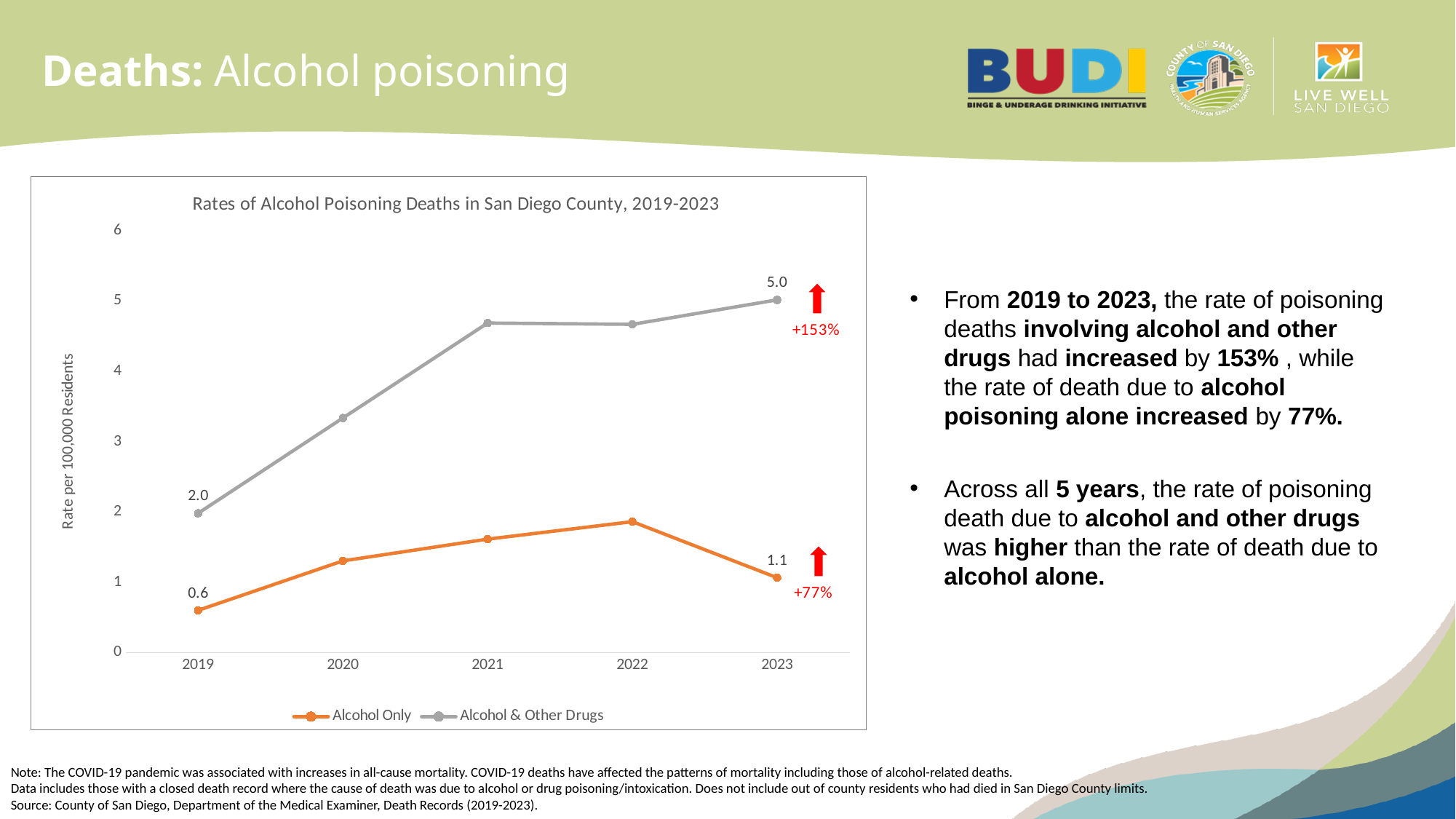
In 2023, which series has the higher rate, Alcohol Only or Alcohol & Other Drugs? Alcohol & Other Drugs What is the Alcohol Only rate in 2019? 0.6 By how much did the Alcohol & Other Drugs rate increase from 2019 to 2023? 3.0 What is the label on the y axis? Rate per 100,000 Residents In which year is the Alcohol Only rate lowest? 2019 What is the Alcohol & Other Drugs rate in 2023? 5.0 Is the Alcohol & Other Drugs value for 2021 greater or less than 4? greater How many years are plotted on the x axis? 5 What kind of chart is shown on the slide? line chart What is the Alcohol Only rate in 2023? 1.1 What is the Alcohol & Other Drugs rate in 2019? 2.0 How many series does the legend list? 2